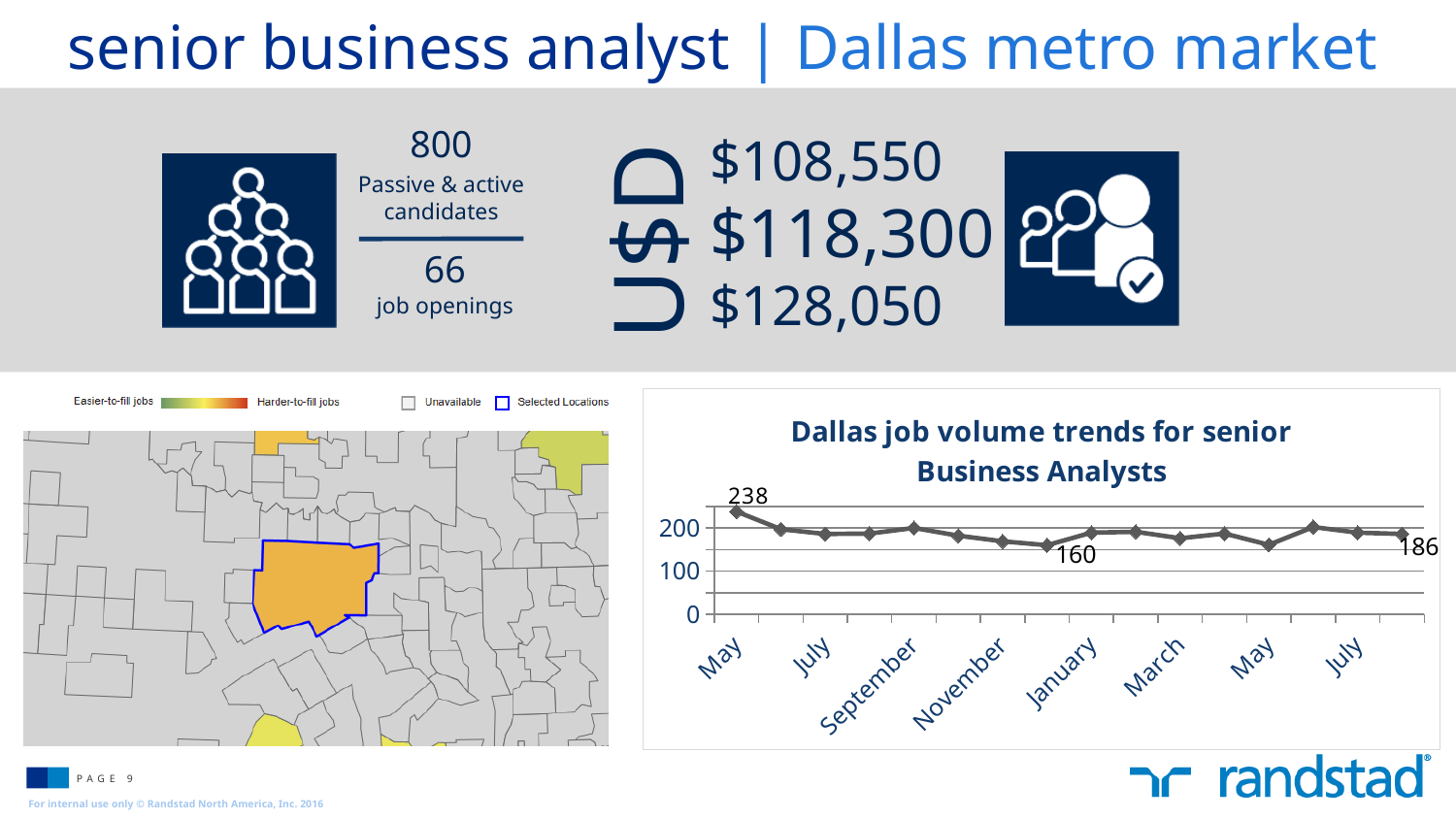
How many month labels are shown on the x axis of the Dallas job volume trends chart? 8 In the Dallas job volume trends chart, is the value for March greater or less than 200? less In the Dallas job volume trends chart, is the value for September greater or less than 100? greater In the Dallas job volume trends chart, which is larger: the value at the first May or the value at the final July? the first May In the Dallas job volume trends chart, what is the value labeled at the first point (May)? 238 In the Dallas job volume trends chart, what is the difference between the first labeled value (238) and the last labeled value (186)? 52 What kind of chart is the 'Dallas job volume trends for senior Business Analysts' chart? line chart In the Dallas job volume trends chart, what is the value labeled at the last point (July)? 186 In the Dallas job volume trends chart, what is the lowest value labeled on the line? 160 In the Dallas job volume trends chart, what is the difference between the highest labeled value (238) and the lowest labeled value (160)? 78 In the Dallas job volume trends chart, which point has the highest value? the first May (238) In the Dallas job volume trends chart, does the job volume overall rise or fall from the first point to the last point? fall